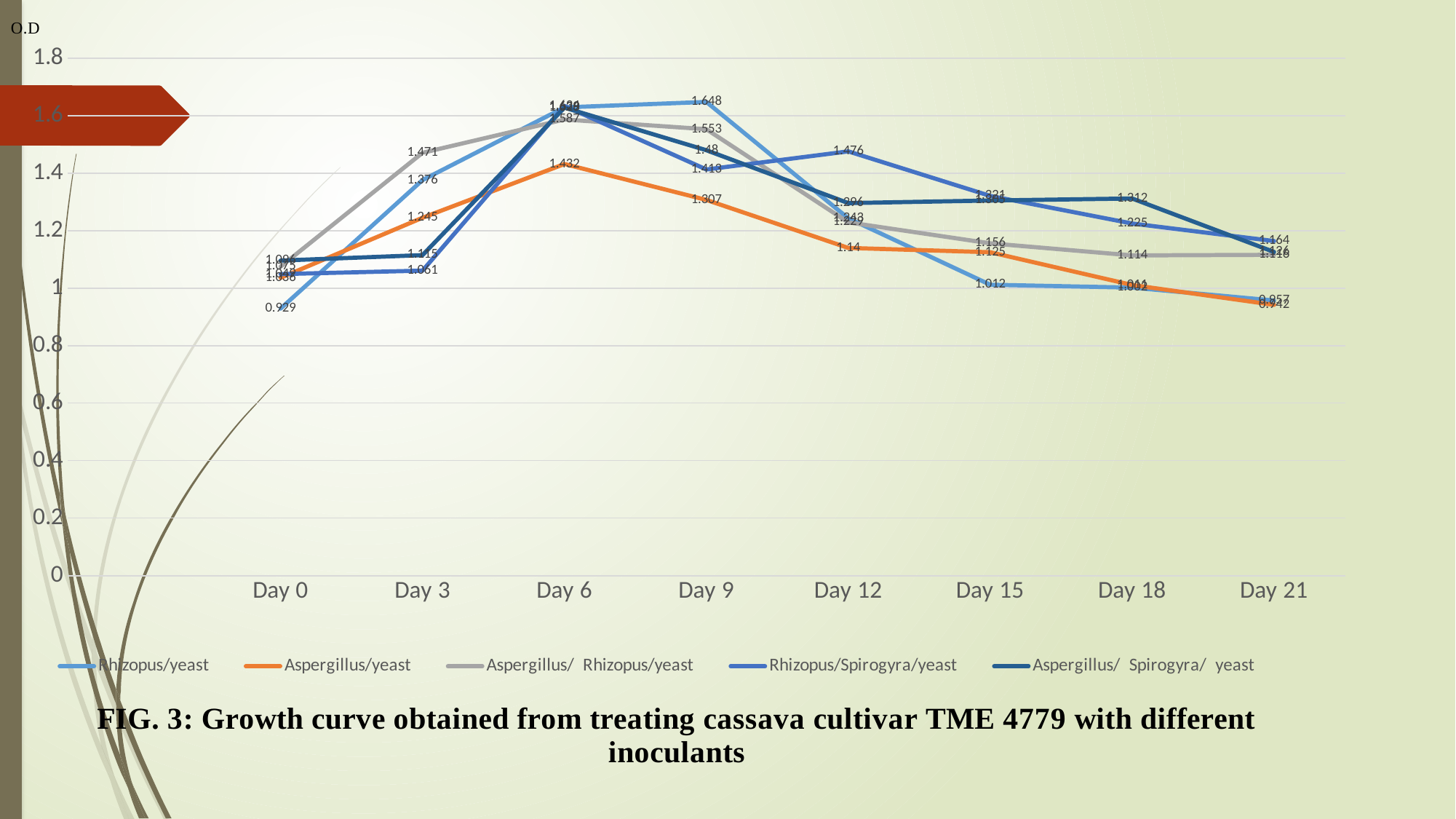
What is the value for Aspergillus/ Rhizopus/yeast at Day 3? 1.471 What kind of chart is shown on the slide? line chart How many series does the legend list? 5 How many time points (days) are plotted along the x axis? 8 What is the value for Rhizopus/Spirogyra/yeast at Day 12? 1.476 What is the value for Rhizopus/yeast at Day 0? 0.929 What is the value for Aspergillus/yeast at Day 6? 1.432 Is the value for Rhizopus/Spirogyra/yeast at Day 3 greater or less than 1.2? less What is the difference between the Aspergillus/yeast values at Day 6 and Day 3? 0.187 What is the value for Aspergillus/ Spirogyra/ yeast at Day 18? 1.312 At Day 9, which is larger: Rhizopus/yeast or Aspergillus/yeast? Rhizopus/yeast At which day does Aspergillus/yeast reach its highest value? Day 6